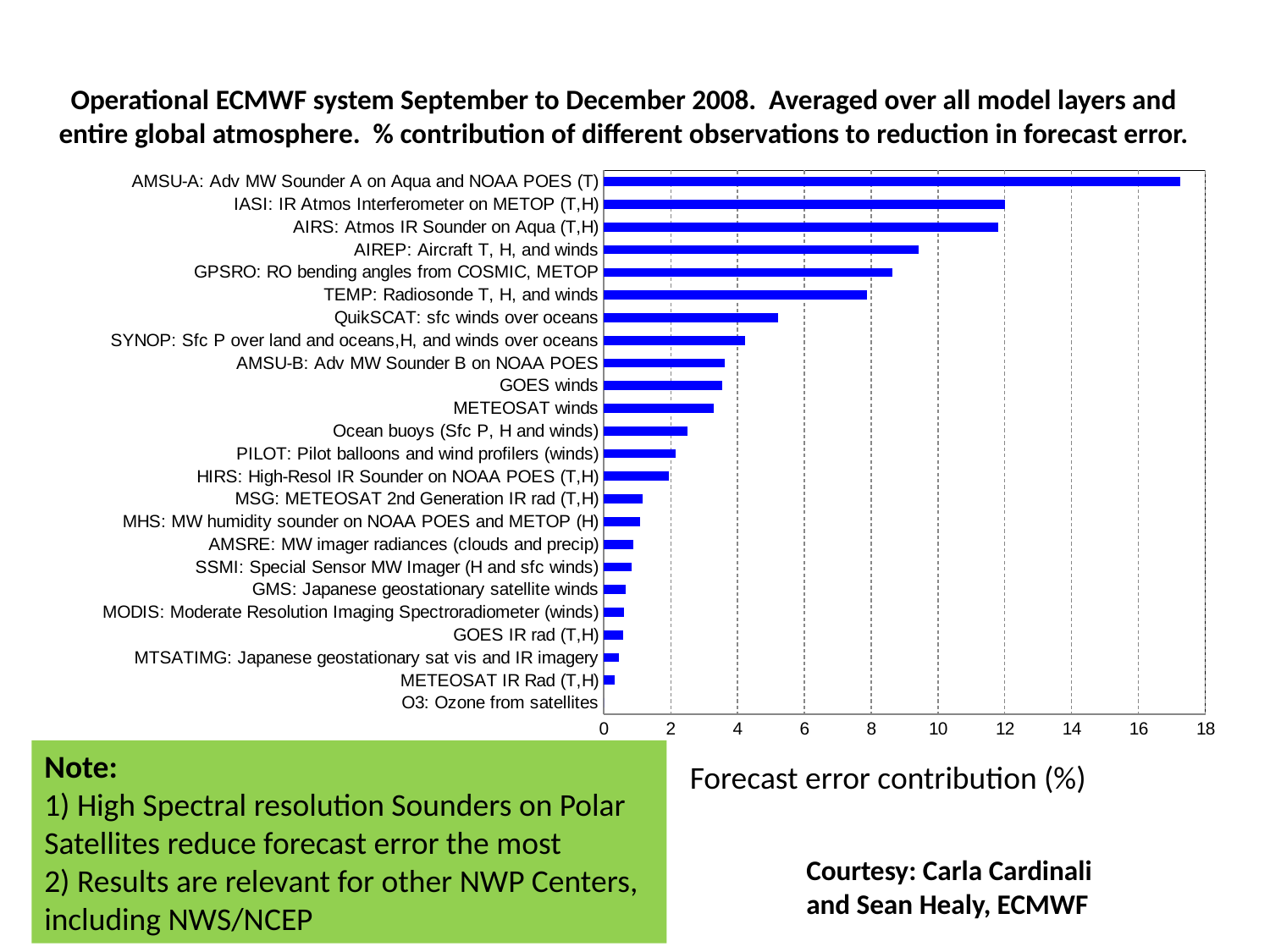
Is the value for AIREP: Aircraft T, H, and winds greater or less than 8? greater Which observation type has the lowest forecast error contribution? O3: Ozone from satellites What is the label of the horizontal axis of the chart? Forecast error contribution (%) Which has a larger forecast error contribution, TEMP: Radiosonde T, H, and winds or QuikSCAT: sfc winds over oceans? TEMP: Radiosonde T, H, and winds How many observation types are listed on the chart? 24 Is the value for QuikSCAT: sfc winds over oceans greater or less than 4? greater Which has a larger forecast error contribution, AIREP: Aircraft T, H, and winds or GPSRO: RO bending angles from COSMIC, METOP? AIREP: Aircraft T, H, and winds What kind of chart is shown on the slide? bar chart Is the value for Ocean buoys (Sfc P, H and winds) greater or less than 2? greater Which observation type has the highest forecast error contribution? AMSU-A: Adv MW Sounder A on Aqua and NOAA POES (T)